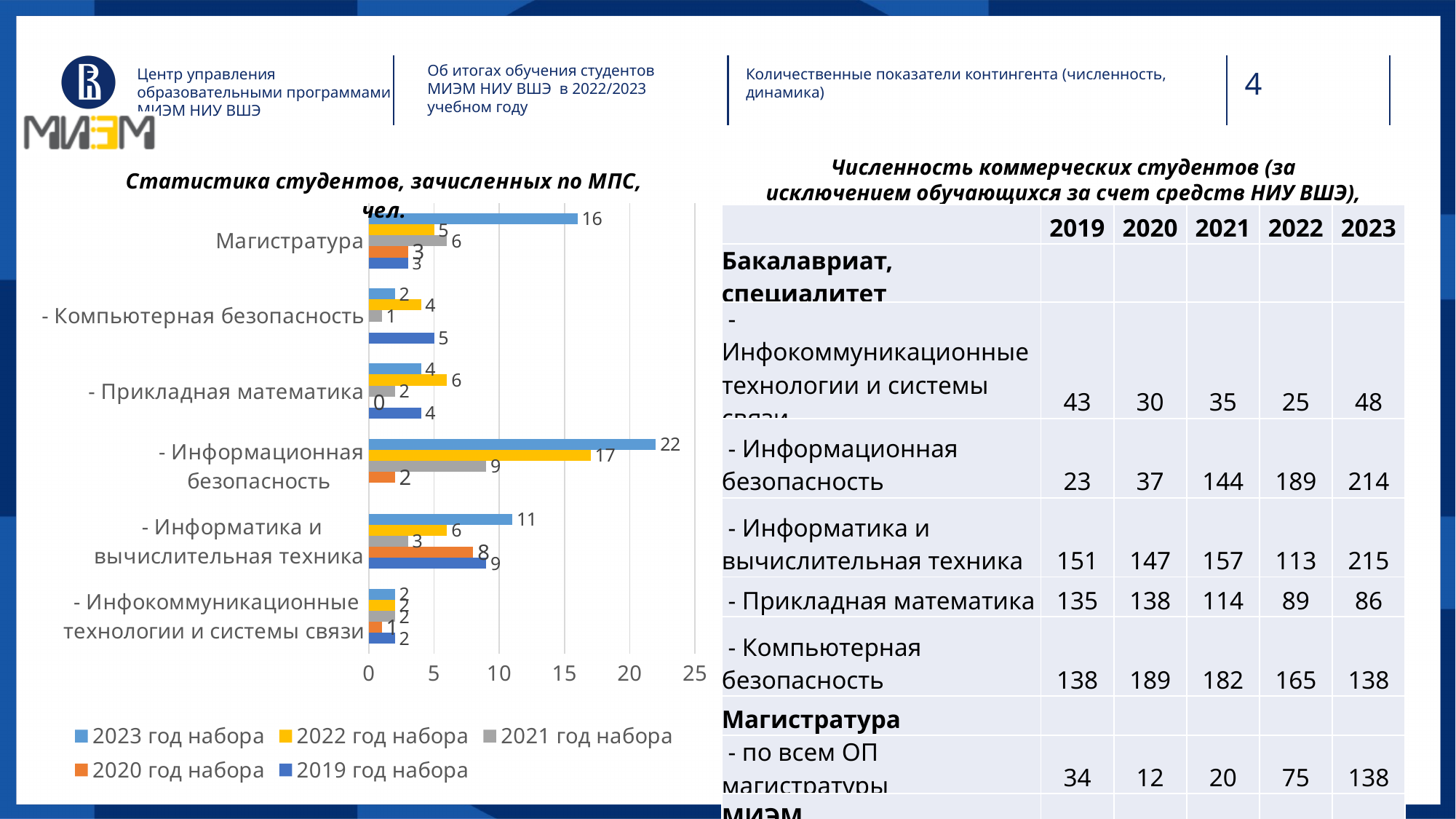
In the bar chart, what is the value for Информатика и вычислительная техника in the 2019 год набора series? 9 In the bar chart, is the 2023 год набора value for Информационная безопасность greater or less than 20? greater In the bar chart, which is larger for Компьютерная безопасность: the 2022 год набора value or the 2019 год набора value? 2019 год набора In the bar chart, what is the difference between the 2023 год набора and 2022 год набора values for Информационная безопасность? 5 In the bar chart, which category has the lowest value in the 2020 год набора series? Прикладная математика What kind of chart is shown on the left of the slide? bar chart In the bar chart, what is the value for Информационная безопасность in the 2022 год набора series? 17 In the bar chart, which category has the highest value in the 2023 год набора series? Информационная безопасность How many series does the legend of the bar chart list? 5 What is the title of the bar chart on the left of the slide? Статистика студентов, зачисленных по МПС, чел. How many categories are shown on the bar chart? 6 In the bar chart, what is the value for Магистратура in the 2023 год набора series? 16